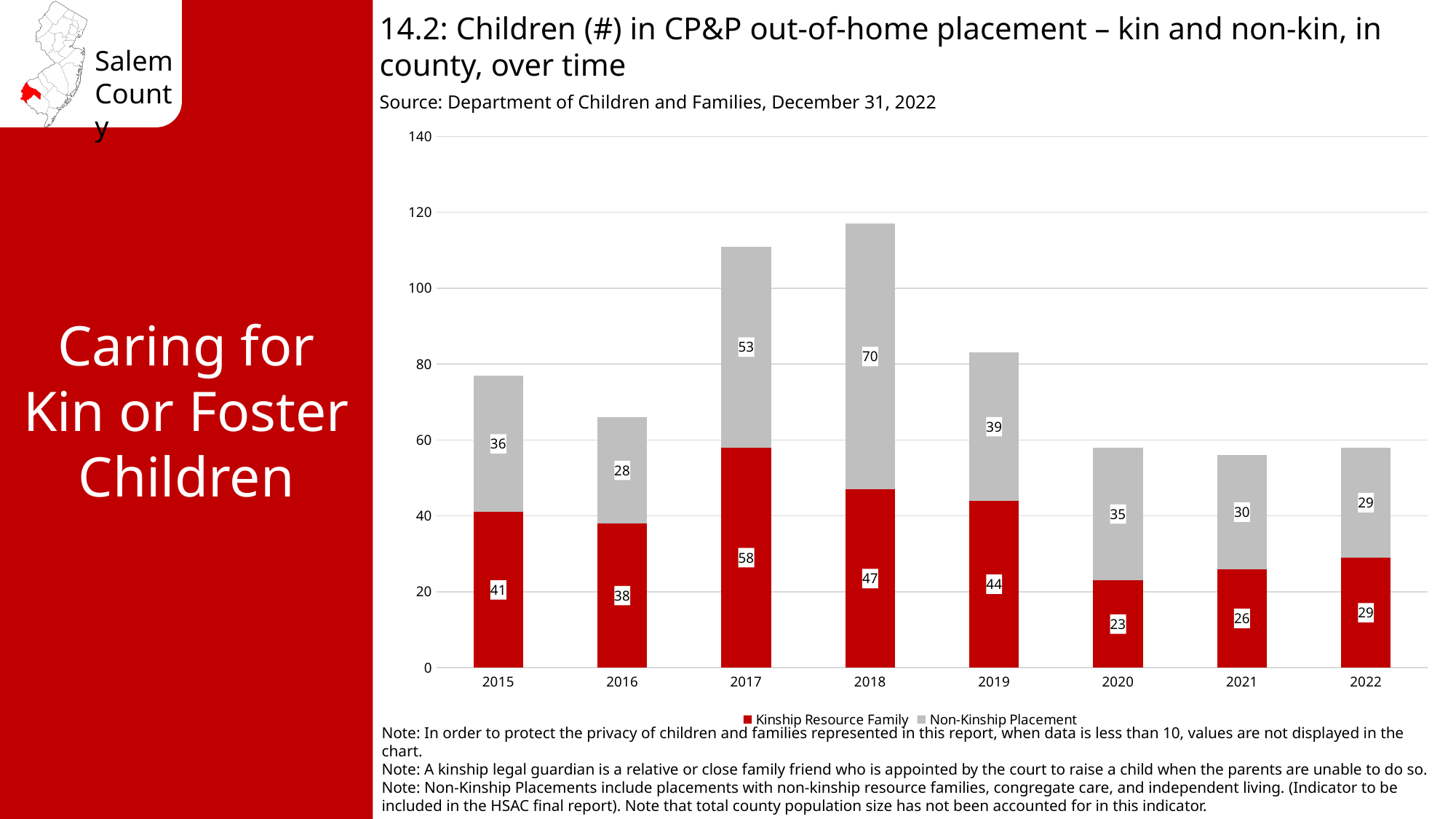
How many years are shown on the x axis? 8 Which year has the highest Non-Kinship Placement value? 2018 What kind of chart is shown on the slide? Stacked bar chart How many series does the legend list? 2 What is the Kinship Resource Family value for 2017? 58 Which year has the lowest Kinship Resource Family value? 2020 What is the Non-Kinship Placement value for 2018? 70 What is the total of the stacked bar for 2022? 58 What is the total number of children in out-of-home placement in 2018 (both series combined)? 117 What is the difference between the Non-Kinship Placement values for 2018 and 2019? 31 Which is larger in 2016: the Kinship Resource Family value or the Non-Kinship Placement value? Kinship Resource Family What is the Kinship Resource Family value for 2020? 23